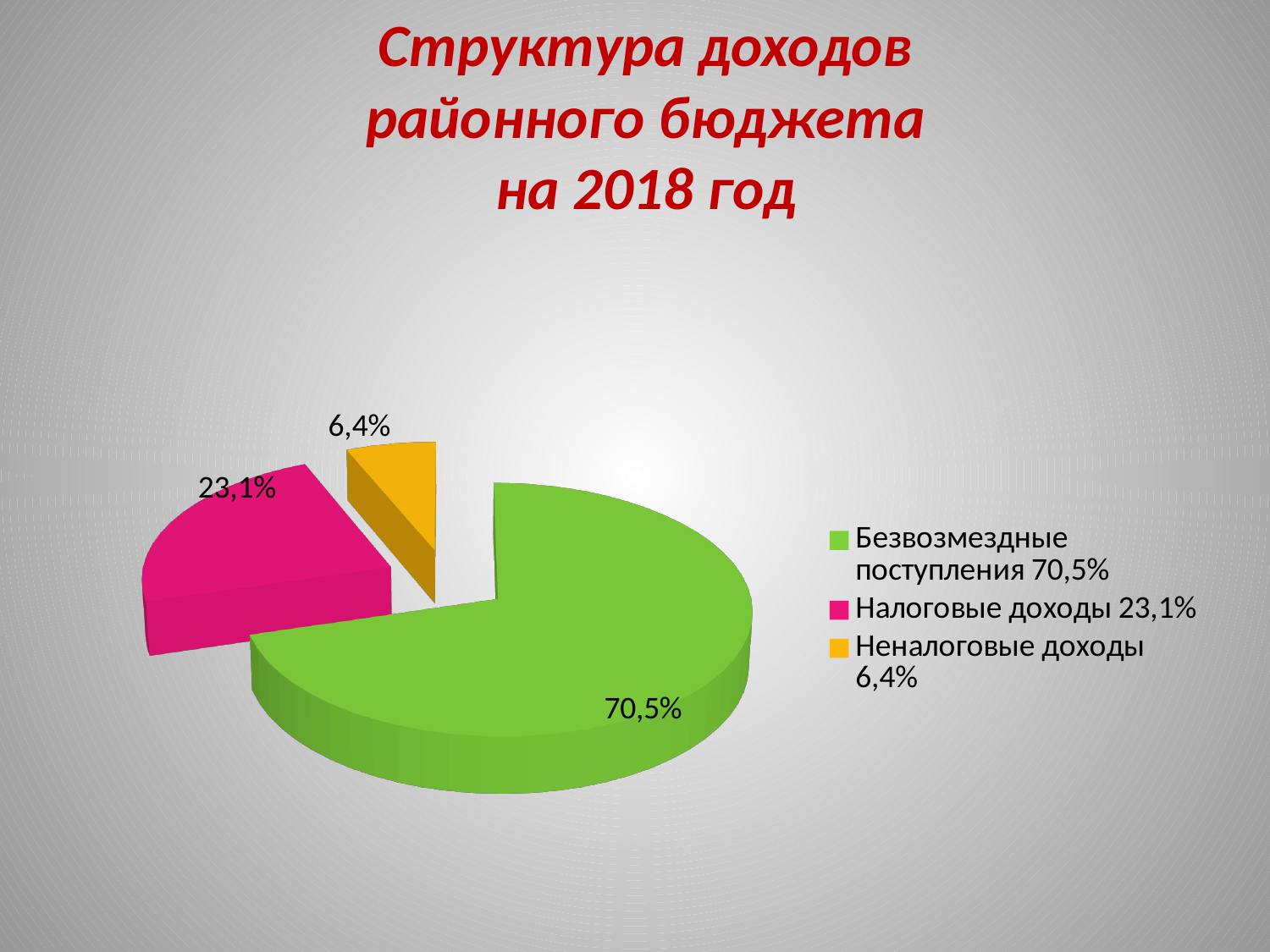
What share of the pie is Налоговые доходы? 23,1% What share of the pie is Безвозмездные поступления? 70,5% What is the title of the chart on the slide? Структура доходов районного бюджета на 2018 год What share of the pie is Неналоговые доходы? 6,4% What is the difference in percentage points between Налоговые доходы and Неналоговые доходы? 16,7 Which category has the largest share of the pie? Безвозмездные поступления Which is larger: Налоговые доходы or Неналоговые доходы? Налоговые доходы How many slices does the pie chart have? 3 What is the difference in percentage points between Безвозмездные поступления and Налоговые доходы? 47,4 What kind of chart is shown on the slide? Pie chart Which category has the smallest share of the pie? Неналоговые доходы What colour is the slice for Неналоговые доходы? Yellow